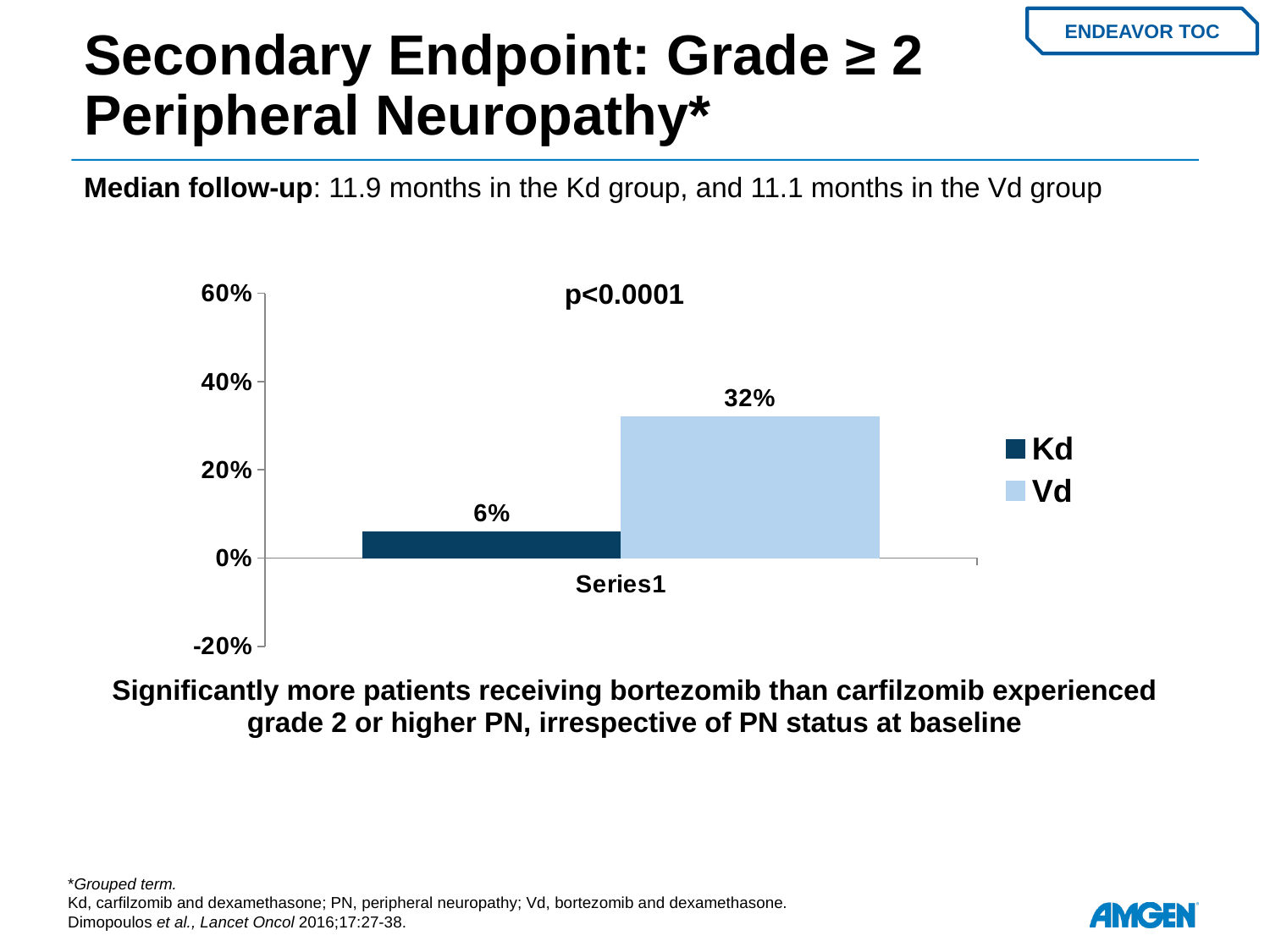
What is the difference between the Vd and Kd values? 26% What p-value is shown on the chart? p<0.0001 What is the value for Vd? 32% Is the value for Vd greater or less than 20%? greater What kind of chart is shown? bar chart Is the value for Kd greater or less than 20%? less Which group has the higher value, Kd or Vd? Vd What is the highest value shown on the y axis? 60% How many series does the legend list? 2 Which series has the lowest value? Kd What is the value for Kd? 6%